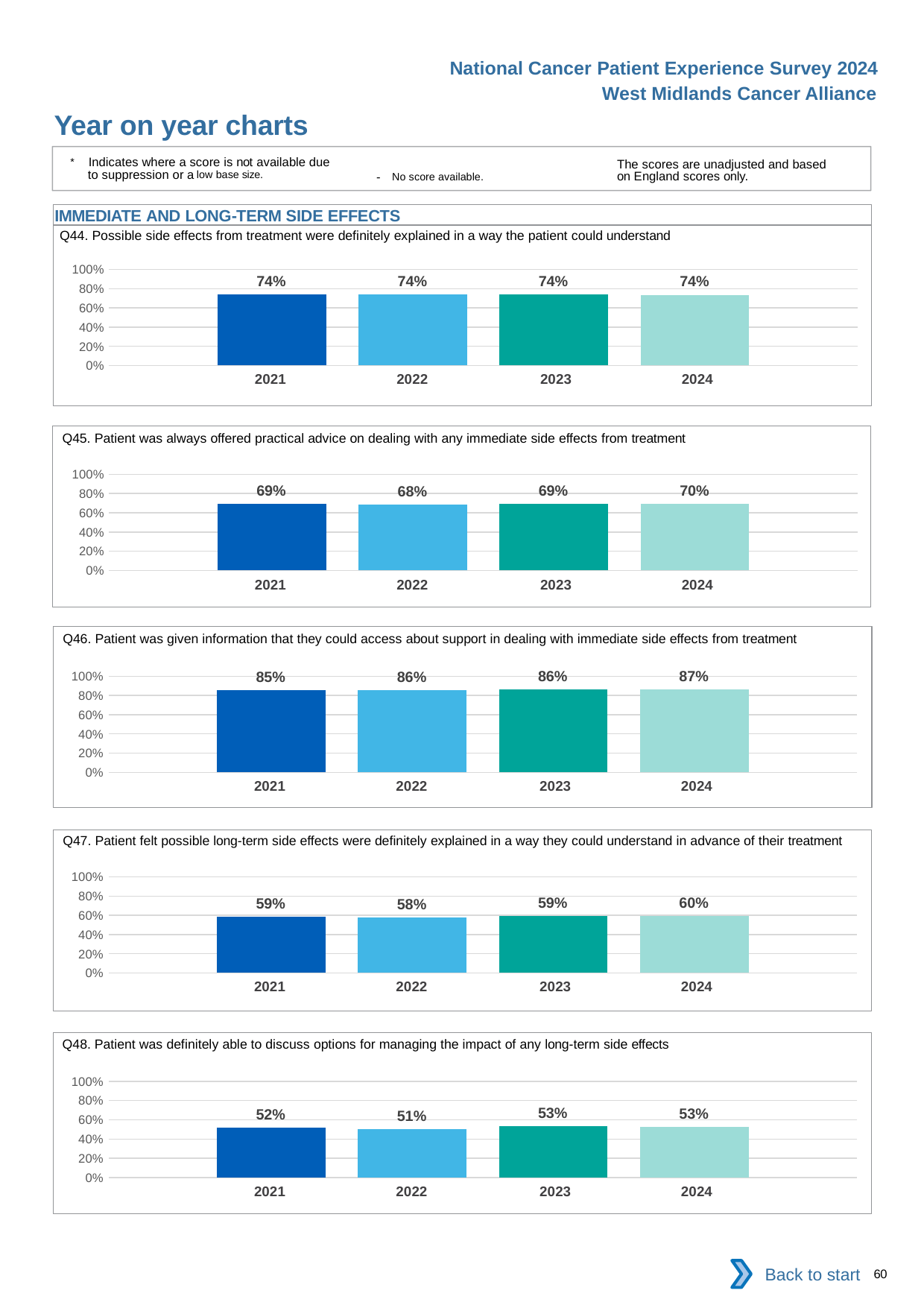
In the Q48 chart, is the value for 2023 greater or less than 40%? greater In the Q44 chart, do the values rise, fall or stay the same from 2021 to 2024? stay the same In the Q47 chart, which is larger, the value for 2022 or the value for 2024? 2024 How many charts are shown on the slide? 5 In the Q44 chart, what is the value for 2024? 74% In the Q46 chart, what is the difference between the 2024 and 2021 values? 2% What kind of chart is used for Q47? bar chart How many years are shown in the Q46 chart? 4 In the Q45 chart, which year has the highest value? 2024 In the Q47 chart, what is the value for 2021? 59% In the Q45 chart, which year has the lowest value? 2022 In the Q48 chart, what is the value for 2022? 51%